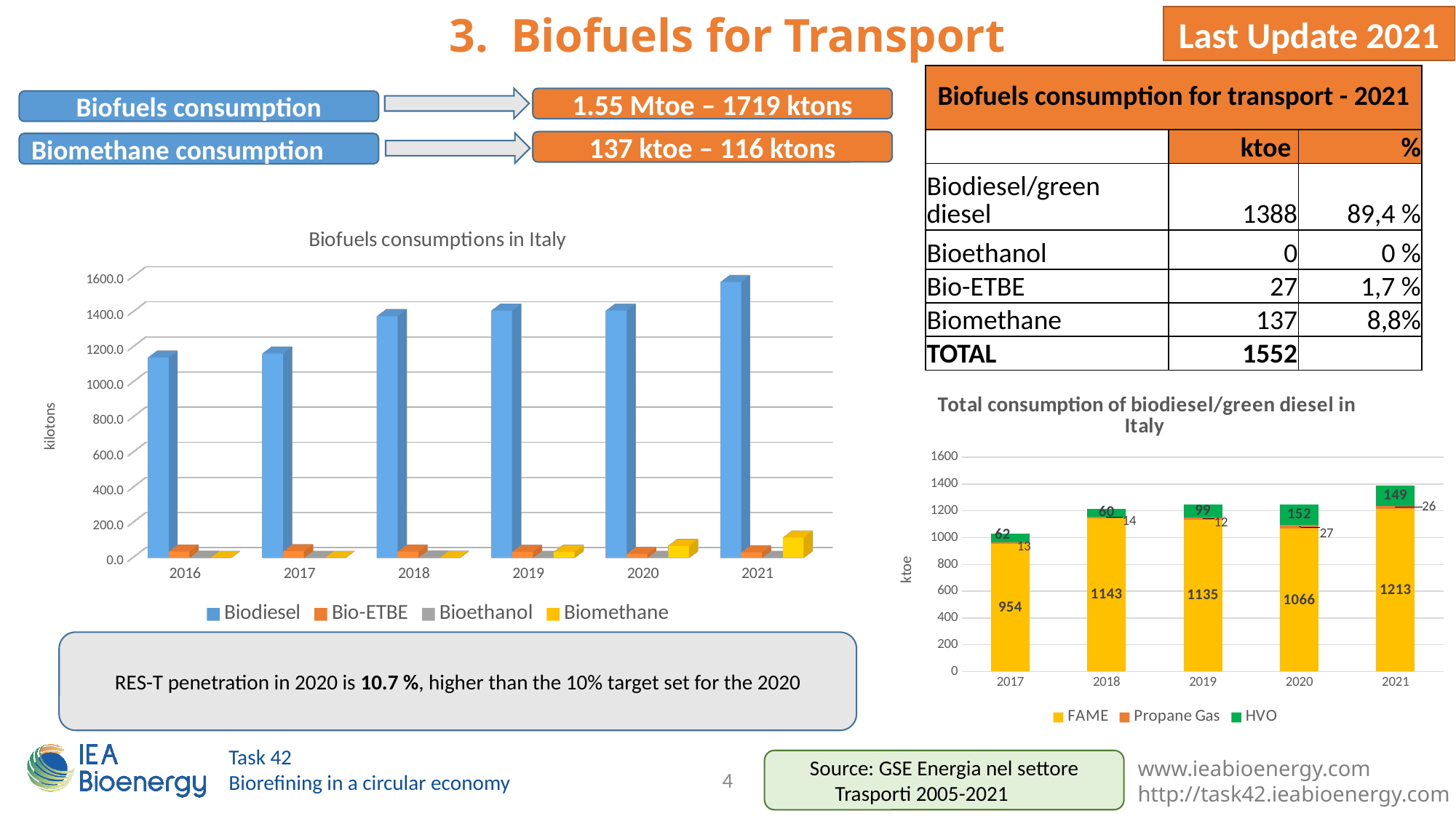
In the 'Biofuels consumptions in Italy' chart, is the Biodiesel value for 2021 greater or less than 1400.0? greater In the 'Total consumption of biodiesel/green diesel in Italy' chart, what is the total of the stacked bar for 2021? 1388 In the 'Biofuels consumptions in Italy' chart, which year has the highest Biodiesel value? 2021 In the 'Biofuels consumptions in Italy' chart, how many years are shown on the x axis? 6 What kind of chart is 'Biofuels consumptions in Italy'? Bar chart In the 'Total consumption of biodiesel/green diesel in Italy' chart, what is the Propane Gas value for 2019? 12 In the 'Total consumption of biodiesel/green diesel in Italy' chart, what is the FAME value for 2021? 1213 In the 'Total consumption of biodiesel/green diesel in Italy' chart, which year has the lowest FAME value? 2017 In the 'Total consumption of biodiesel/green diesel in Italy' chart, which year has the highest FAME value? 2021 In the 'Total consumption of biodiesel/green diesel in Italy' chart, what is the HVO value for 2020? 152 In the 'Total consumption of biodiesel/green diesel in Italy' chart, what is the difference between the FAME values for 2021 and 2017? 259 In the 'Total consumption of biodiesel/green diesel in Italy' chart, how many series does the legend list? 3